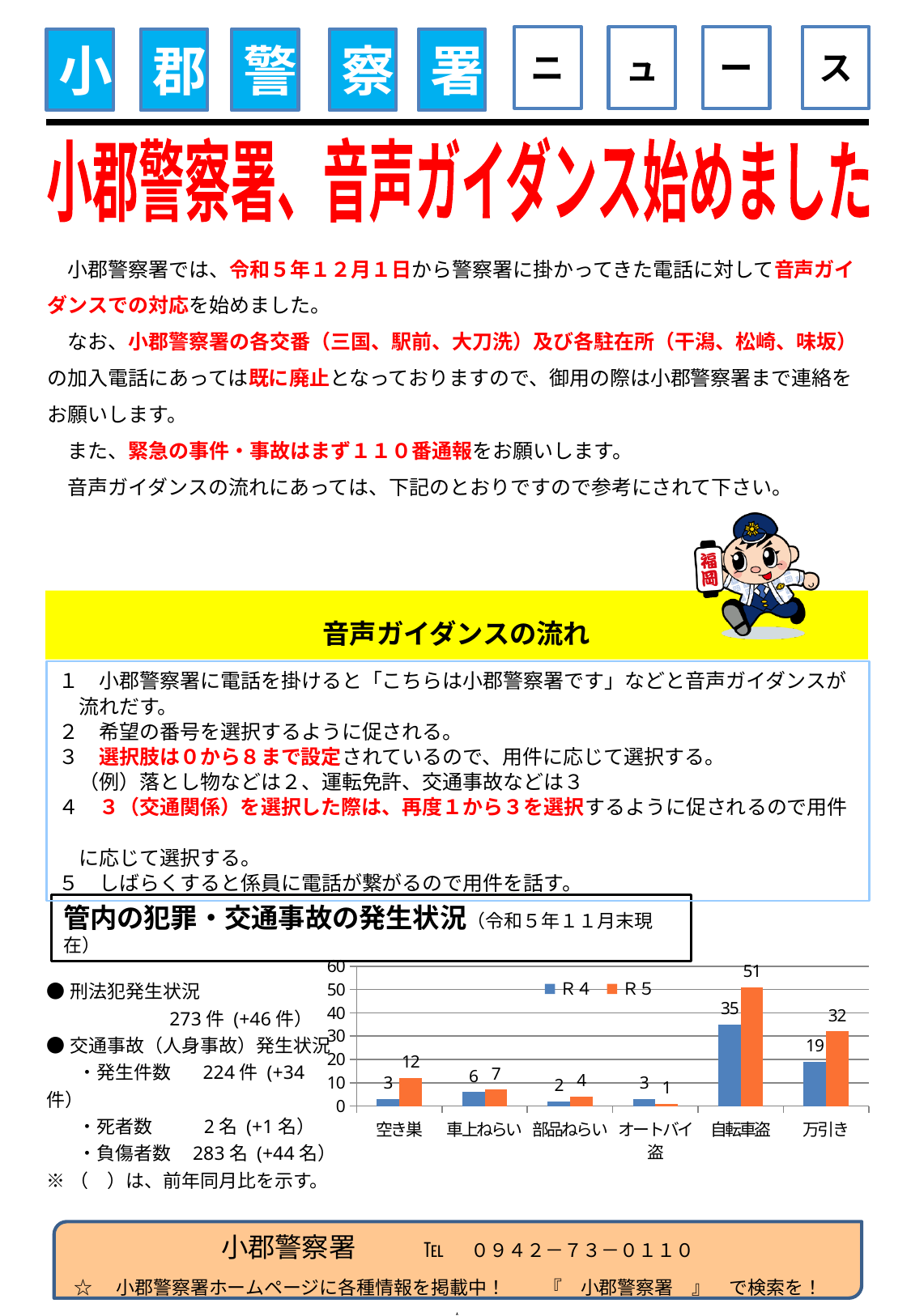
Is the R5 value for 万引き greater or less than 30? greater What is the R5 value for 空き巣 in the chart? 12 Which category has the highest R5 value in the chart? 自転車盗 What is the R5 value for 自転車盗 in the chart? 51 How many series does the chart legend list? 2 Which is larger for オートバイ盗, the R4 value or the R5 value? R4 How many categories are shown on the x axis of the chart? 6 What is the R4 value for 万引き in the chart? 19 What is the difference between the R5 and R4 values for 自転車盗? 16 Which category has the lowest R4 value in the chart? 部品ねらい What kind of chart is shown on the slide? bar chart What are the two series names in the chart legend? R4 and R5